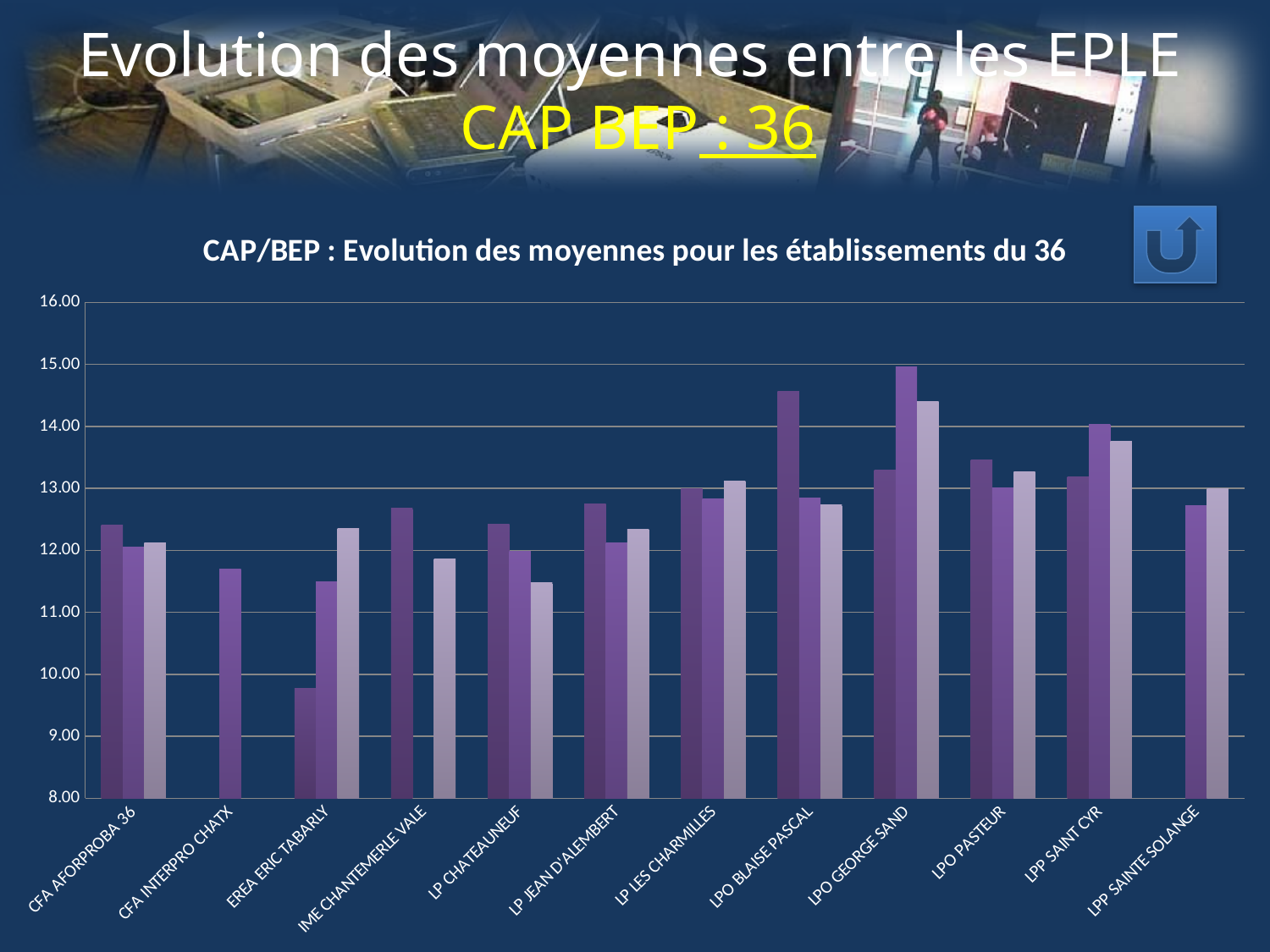
Which establishment has the shortest bar in the chart? EREA ERIC TABARLY Which establishment has only one bar plotted in the chart? CFA INTERPRO CHATX What kind of chart is shown on the slide? bar chart Is the value of the single bar for CFA INTERPRO CHATX greater or less than 12.00? less Is the value of the darkest (first) bar for EREA ERIC TABARLY greater or less than 10.00? less Is the value of the darkest (first) bar for CFA AFORPROBA 36 greater or less than 12.00? greater What is the title of the chart? CAP/BEP : Evolution des moyennes pour les établissements du 36 Which establishment has the tallest bar in the chart? LPO GEORGE SAND How many establishments (categories) are shown on the x axis of the chart? 12 Which is larger: the bar for CFA INTERPRO CHATX or the darkest (first) bar for LPO PASTEUR? LPO PASTEUR